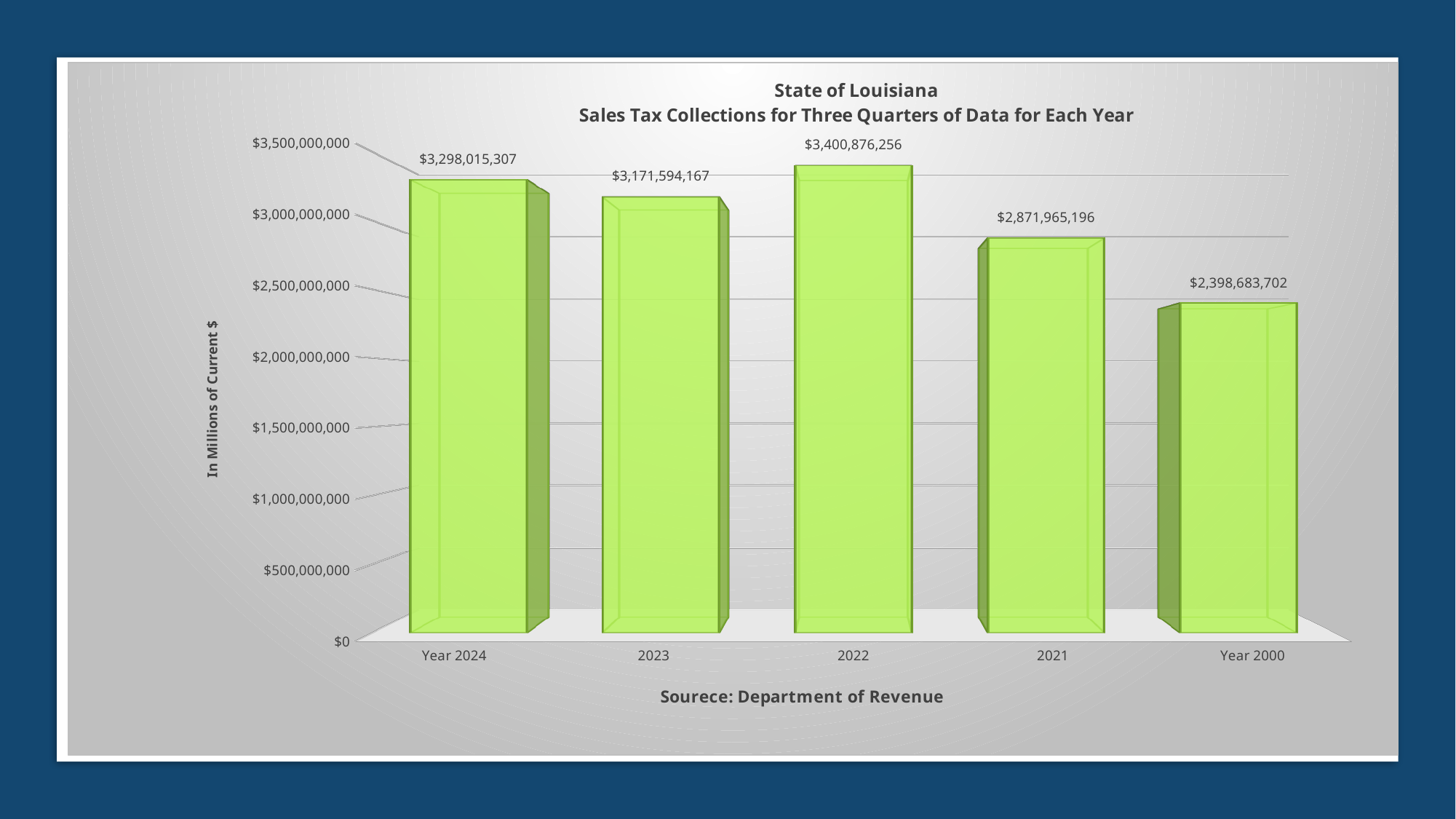
What is the value shown for Year 2000? $2,398,683,702 What is the difference between the values for 2021 and Year 2000? $473,281,494 What kind of chart is shown on the slide? bar chart Which year has the highest sales tax collections? 2022 How many years are shown on the chart? 5 What source is cited below the chart? Department of Revenue Which is larger, the value for Year 2024 or the value for 2023? Year 2024 Is the value for 2021 greater or less than $3,000,000,000? less What is the value shown for 2021? $2,871,965,196 What is the difference between the values for 2022 and Year 2024? $102,860,949 What is the sales tax collection value shown for Year 2024? $3,298,015,307 Which year has the lowest sales tax collections? Year 2000